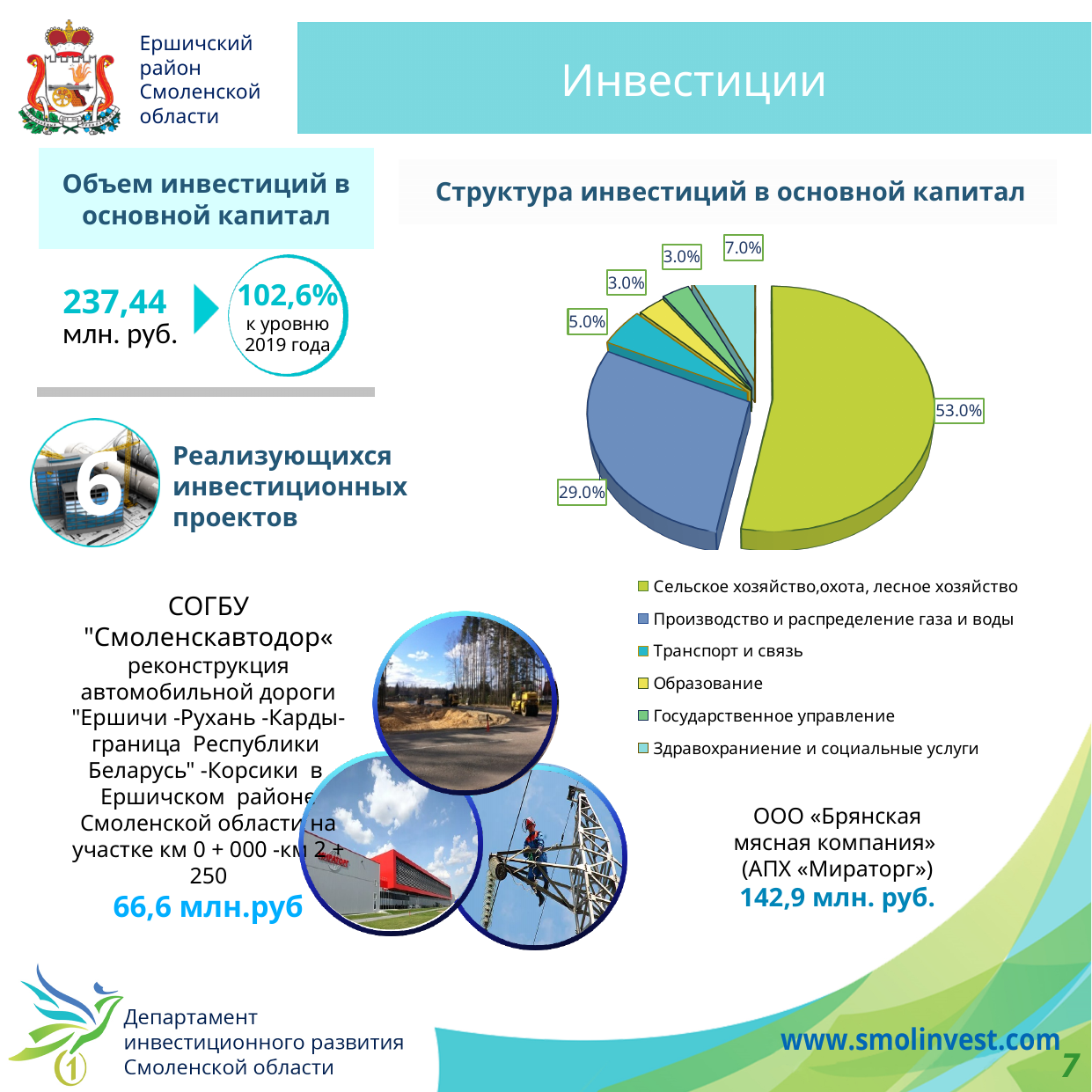
In the pie chart «Структура инвестиций в основной капитал», what share does «Здравоохранение и социальные услуги» have? 7.0% In the pie chart «Структура инвестиций в основной капитал», what share does «Транспорт и связь» have? 5.0% In the pie chart «Структура инвестиций в основной капитал», which is larger: «Здравоохранение и социальные услуги» or «Транспорт и связь»? Здравоохранение и социальные услуги What colour is the slice for «Производство и распределение газа и воды» in the pie chart «Структура инвестиций в основной капитал»? blue Which category has the largest slice in the pie chart «Структура инвестиций в основной капитал»? Сельское хозяйство, охота, лесное хозяйство How many categories does the legend of the pie chart «Структура инвестиций в основной капитал» list? 6 In the pie chart «Структура инвестиций в основной капитал», what share does «Производство и распределение газа и воды» have? 29.0% In the pie chart «Структура инвестиций в основной капитал», what share does «Образование» have? 3.0% In the pie chart «Структура инвестиций в основной капитал», what share does «Сельское хозяйство, охота, лесное хозяйство» have? 53.0% In the pie chart «Структура инвестиций в основной капитал», what is the combined share of «Образование» and «Государственное управление»? 6.0% In the pie chart «Структура инвестиций в основной капитал», what is the difference between the shares of «Сельское хозяйство, охота, лесное хозяйство» and «Производство и распределение газа и воды»? 24.0% What type of chart is shown under the title «Структура инвестиций в основной капитал»? pie chart